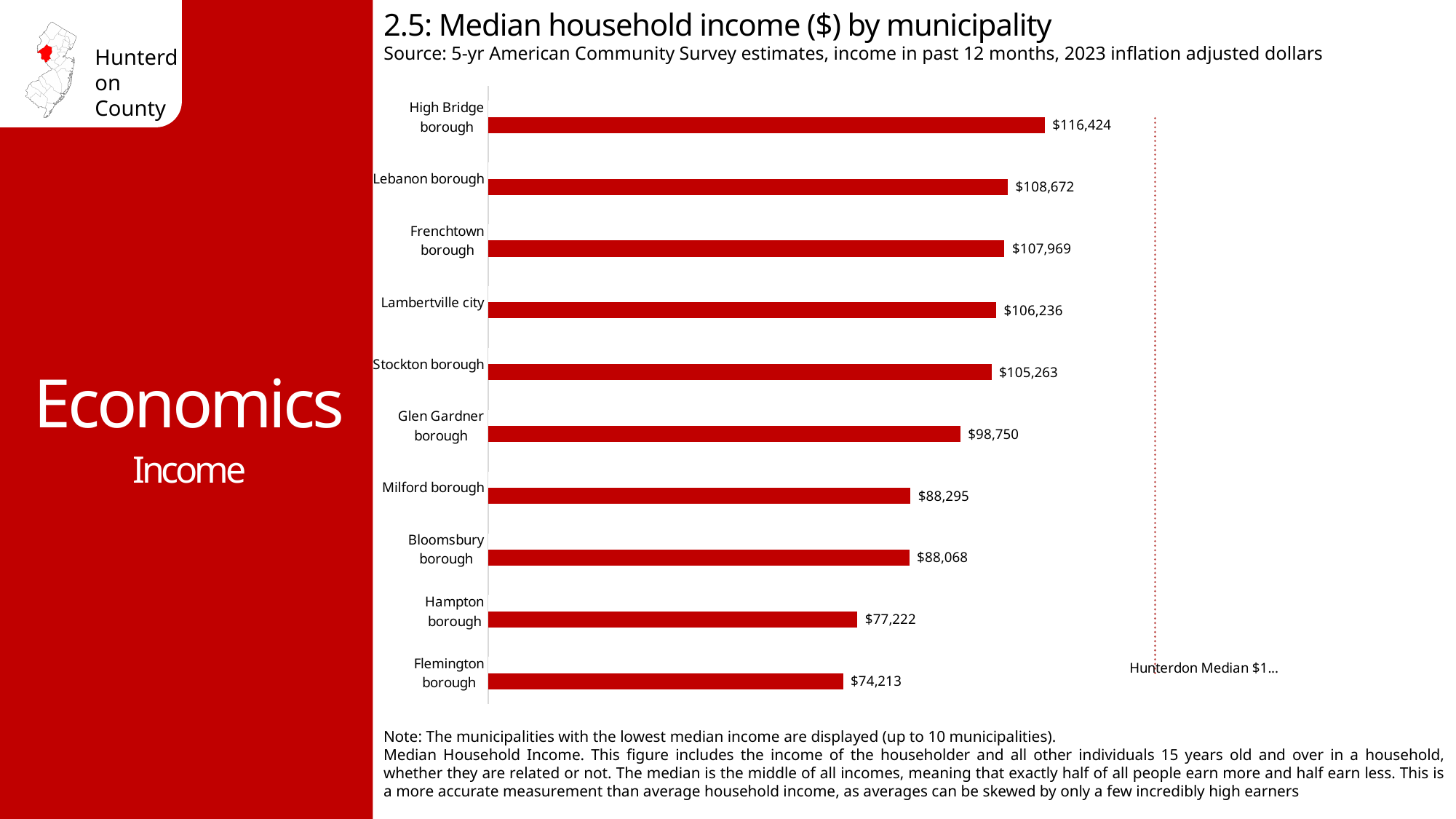
What is the median household income for High Bridge borough? $116,424 What is the title of the chart? 2.5: Median household income ($) by municipality What is the median household income for Glen Gardner borough? $98,750 What type of chart is used to show median household income by municipality? Bar chart How many municipalities are shown on the chart? 10 What is the median household income for Lambertville city? $106,236 What is the difference between the median household income of Milford borough and Bloomsbury borough? $227 What is the difference between the median household income of High Bridge borough and Flemington borough? $42,211 Which municipality has the lowest median household income shown on the chart? Flemington borough What is the median household income for Flemington borough? $74,213 Which municipality has the highest median household income shown on the chart? High Bridge borough Which has a higher median household income, Hampton borough or Stockton borough? Stockton borough